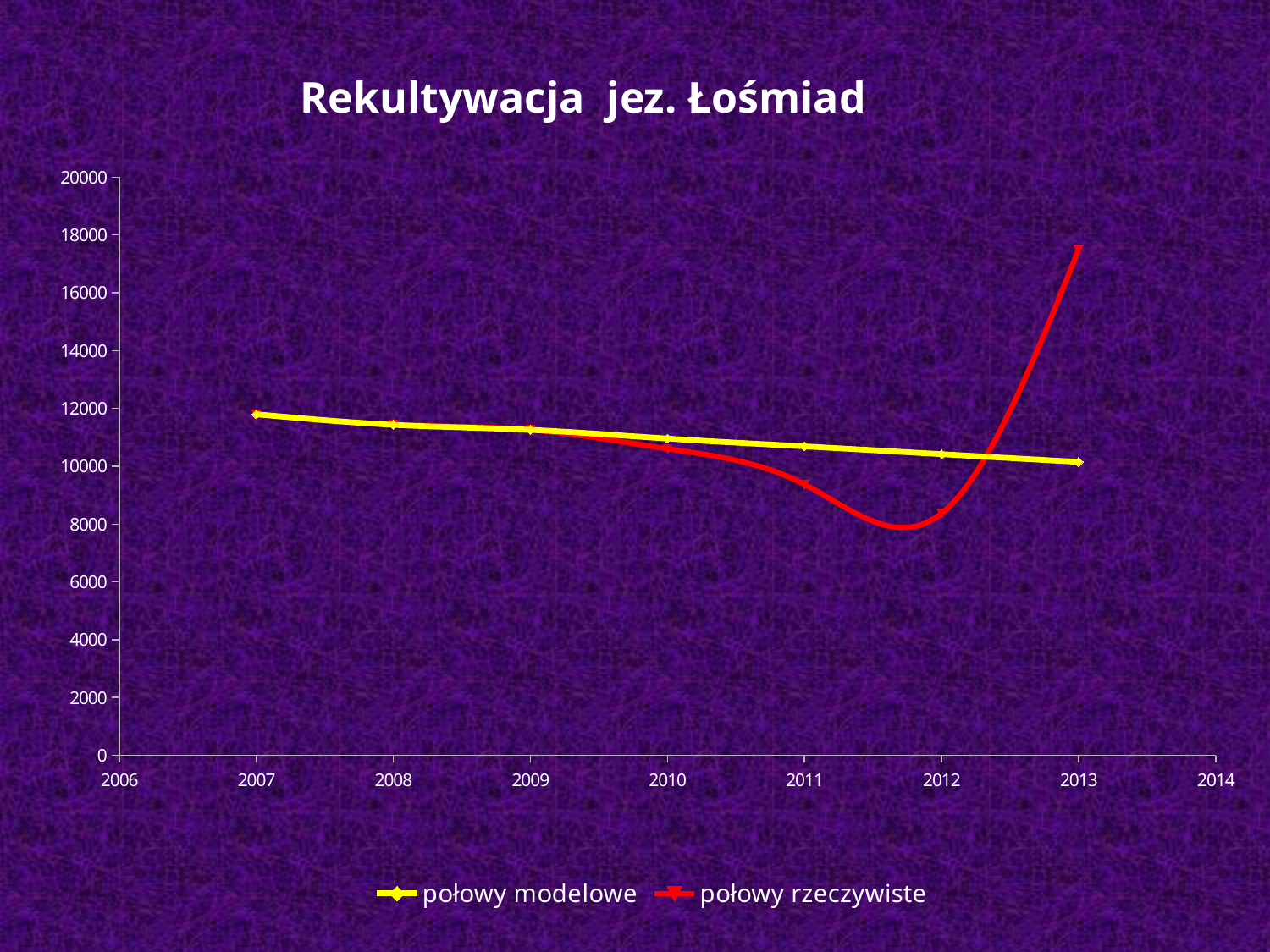
Is the value for "połowy rzeczywiste" in 2013 greater or less than 16000? greater In which year is the value of "połowy rzeczywiste" highest? 2013 In which year is the value of "połowy rzeczywiste" lowest? 2012 Do the values of "połowy modelowe" rise or fall from 2007 to 2013? fall What is the title of the chart? Rekultywacja jez. Łośmiad How many series does the legend list? 2 Which colour is used for the series "połowy rzeczywiste"? red In 2013, which series has the larger value, "połowy modelowe" or "połowy rzeczywiste"? połowy rzeczywiste Is the value for "połowy rzeczywiste" in 2012 greater or less than 10000? less What kind of chart is shown on the slide? line chart In 2011, which series has the larger value, "połowy modelowe" or "połowy rzeczywiste"? połowy modelowe How many data points does the "połowy modelowe" series have? 7